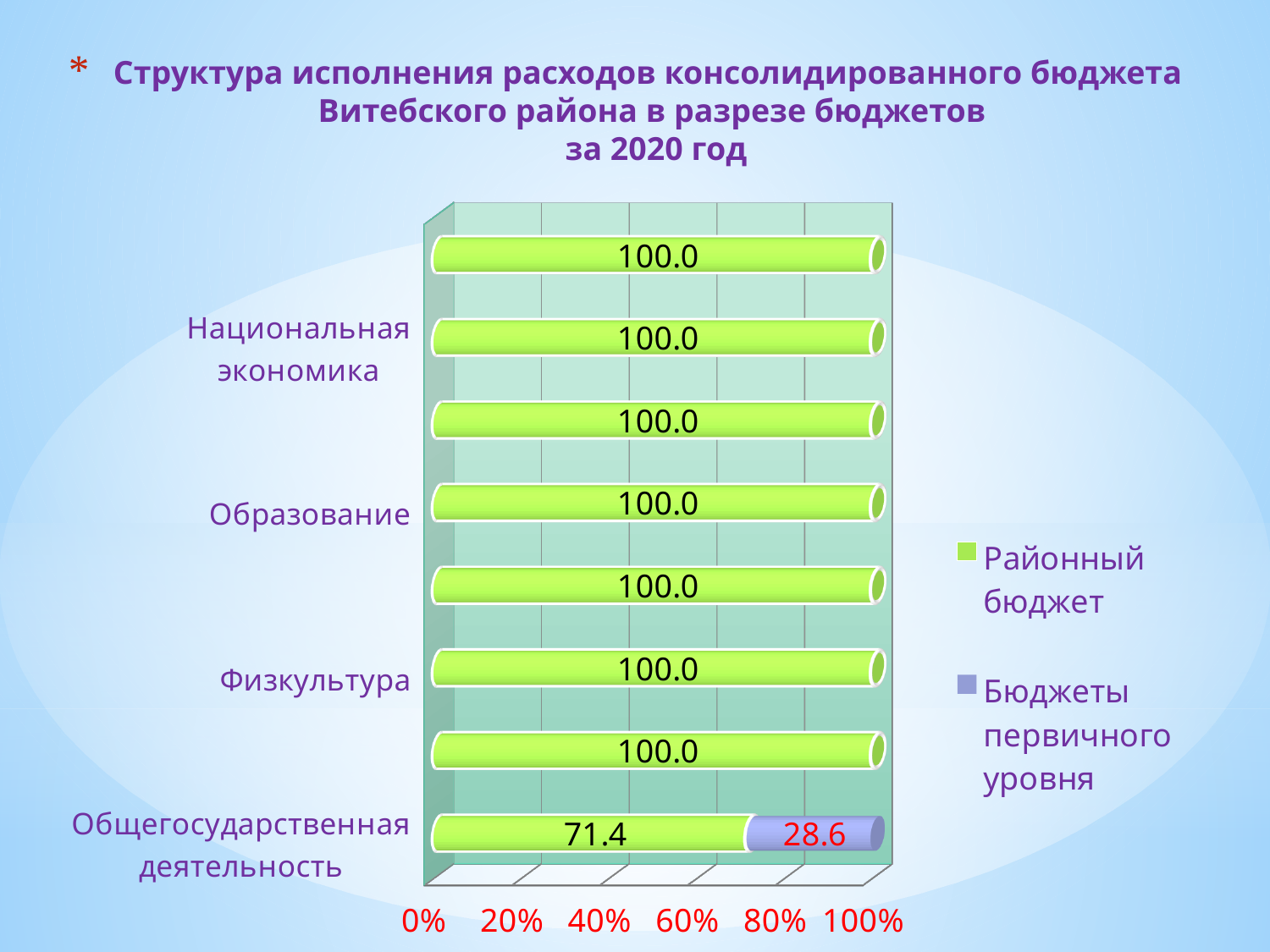
For Общегосударственная деятельность, what is the difference between the Районный бюджет value and the Бюджеты первичного уровня value? 42.8 What is the value of Районный бюджет for Общегосударственная деятельность? 71.4 What is the value of Районный бюджет for Образование? 100.0 How many series does the legend list? 2 What is the value of Районный бюджет for Национальная экономика? 100.0 What type of chart is shown on the slide? bar chart For Общегосударственная деятельность, which series has the larger value: Районный бюджет or Бюджеты первичного уровня? Районный бюджет Is the Районный бюджет value for Общегосударственная деятельность greater or less than 60%? greater What is the value of Районный бюджет for Физкультура? 100.0 Which labelled category has the lowest value for Районный бюджет? Общегосударственная деятельность How many bars are plotted in the chart? 8 What is the value of Бюджеты первичного уровня for Общегосударственная деятельность? 28.6